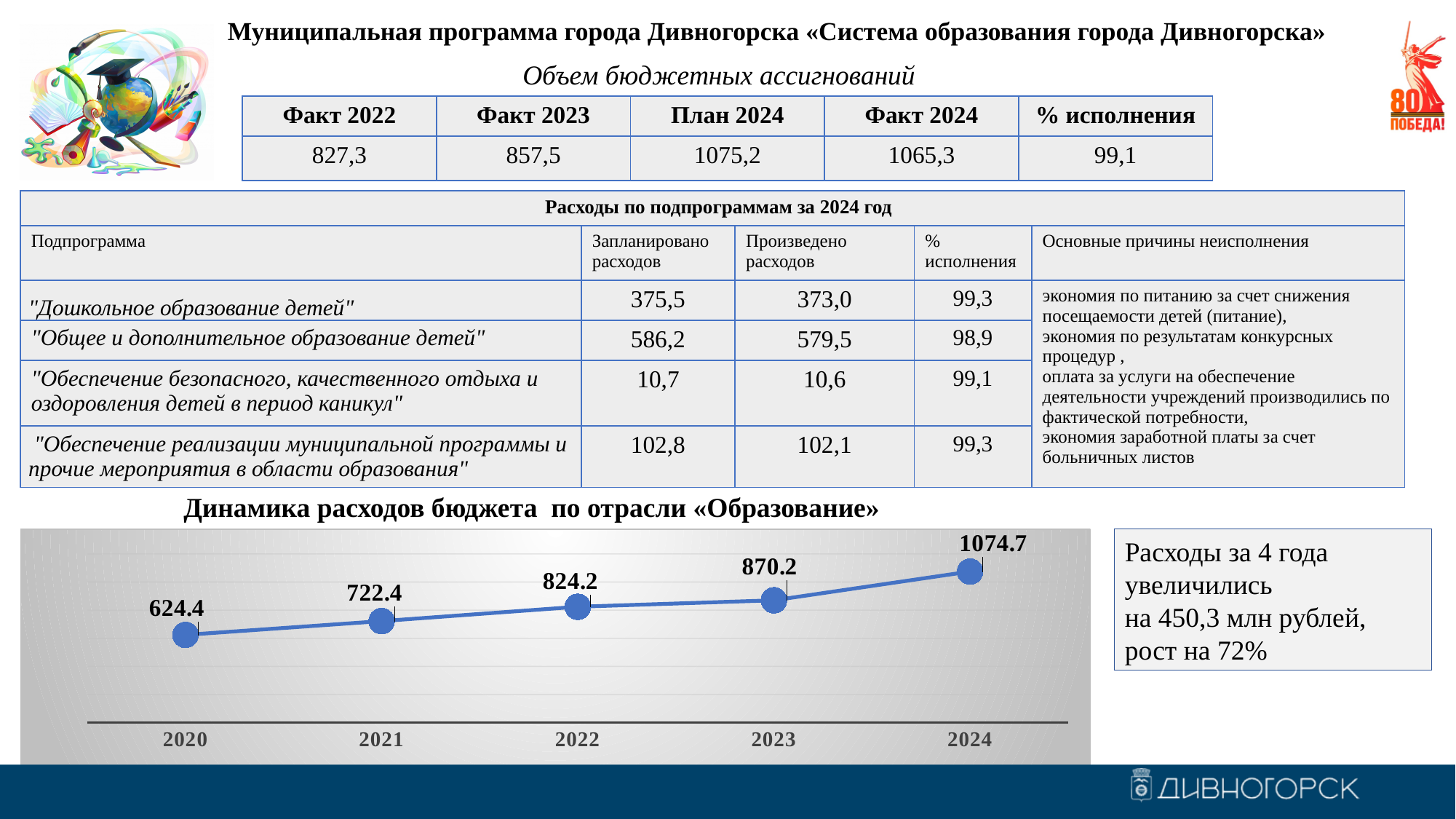
Do the values in the line chart rise or fall from 2020 to 2024? rise In the line chart, what is the value for 2023? 870.2 How many data points are plotted in the line chart? 5 In the line chart, what is the value for 2024? 1074.7 In the line chart, what is the value for 2022? 824.2 In the line chart, which year has the highest value? 2024 In the line chart, which year has the lowest value? 2020 In the line chart, what is the difference between the values for 2021 and 2020? 98.0 In the line chart, which is larger: the value for 2021 or the value for 2023? 2023 What type of chart is shown under the heading «Динамика расходов бюджета по отрасли «Образование»»? line chart In the line chart, what is the difference between the values for 2024 and 2020? 450.3 In the line chart, what is the value for 2020? 624.4